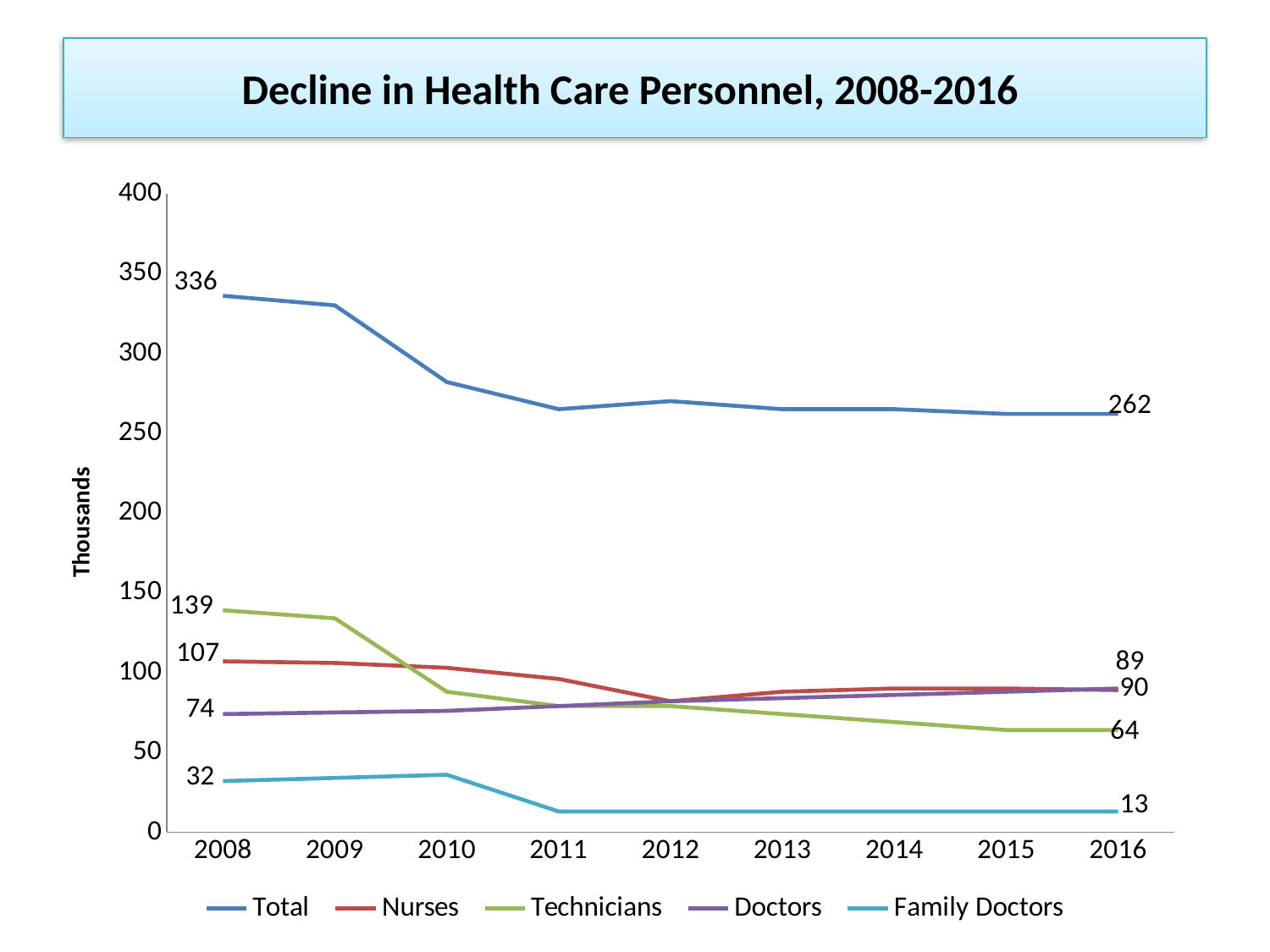
In 2008, which was larger, Technicians or Nurses? Technicians How many years are shown on the x axis? 9 What is the value for Technicians in 2016? 64 What is the value for Family Doctors in 2008? 32 What is the title of the chart? Decline in Health Care Personnel, 2008-2016 By how much did the Total decline from 2008 to 2016? 74 Does the Doctors series rise or fall from 2008 to 2016? rise What is the value for Total in 2008? 336 Which series had the lowest value in 2008? Family Doctors What is the value for Total in 2016? 262 How many series does the legend list? 5 What type of chart is shown on the slide? line chart